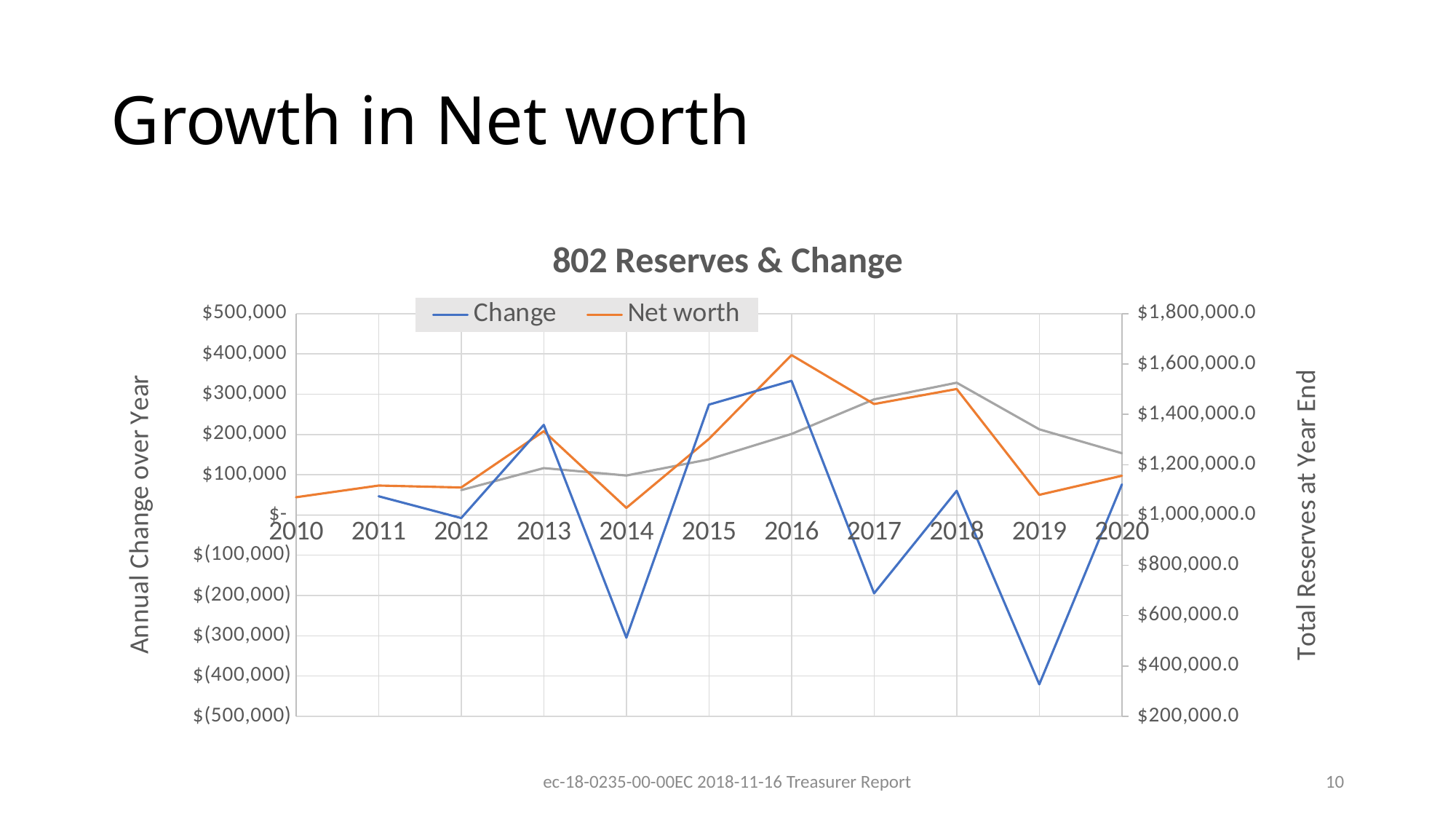
What is the title of the left vertical axis? Annual Change over Year Which year has the larger Change value, 2013 or 2014? 2013 Is the Change value for 2017 greater or less than $(100,000)? less Is the Change value for 2016 greater or less than $300,000? greater How many years are plotted along the x axis? 11 How many series does the chart legend list? 2 In which year is the Change series at its lowest? 2019 Is the Net worth value for 2016 greater or less than $1,400,000.0? greater In which year is the Change series at its highest? 2016 What kind of chart is shown on the slide? Line chart What is the title of the chart? 802 Reserves & Change In which year is the Net worth series at its highest? 2016